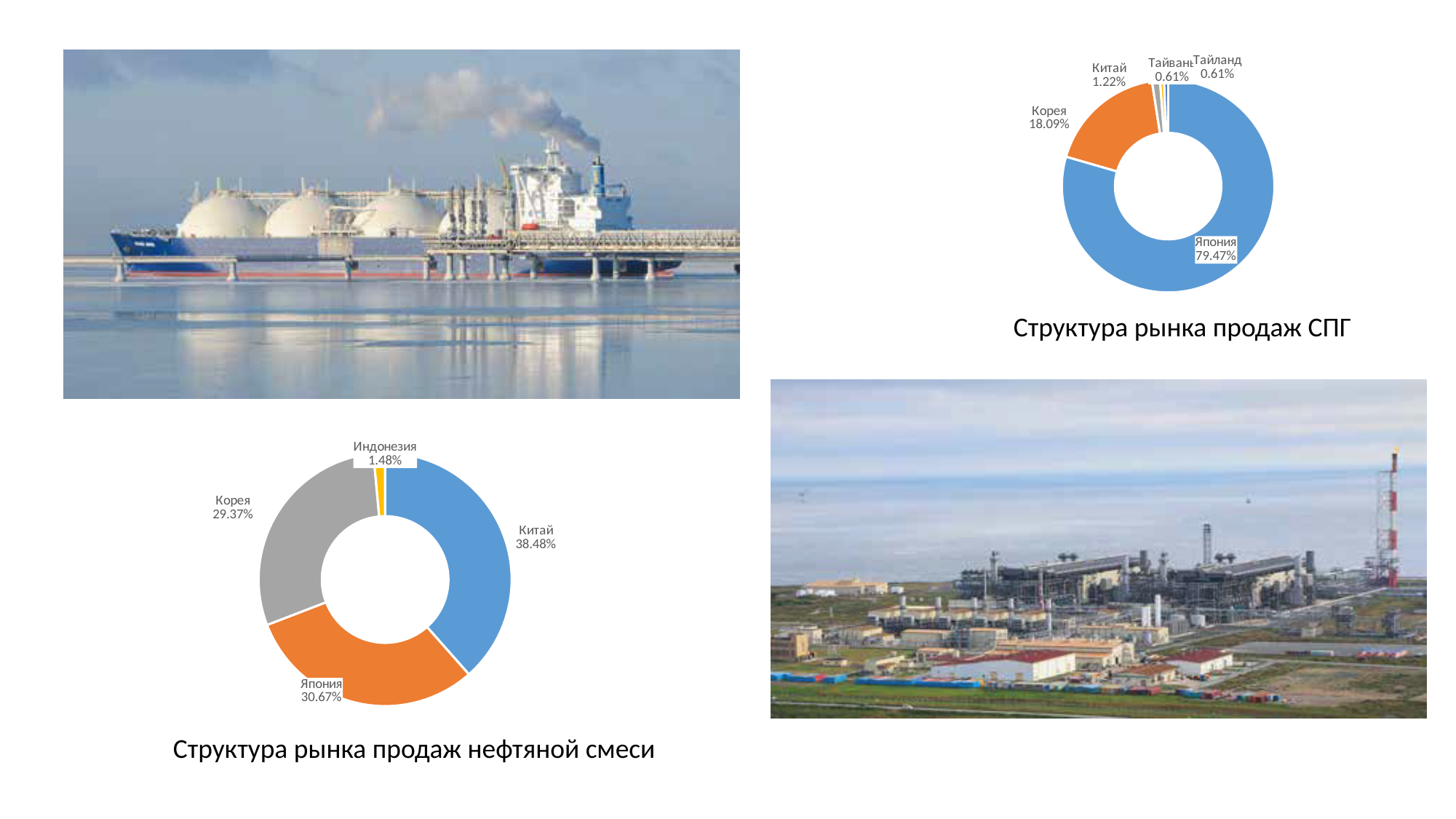
In the chart titled "Структура рынка продаж СПГ", which category has the largest share? Япония In the chart titled "Структура рынка продаж нефтяной смеси", which category has the smallest share? Индонезия In the chart titled "Структура рынка продаж СПГ", what share does Корея have? 18.09% In the chart titled "Структура рынка продаж СПГ", how many categories are shown? 5 In the chart titled "Структура рынка продаж СПГ", what is the difference between the shares of Япония and Корея? 61.38% In the chart titled "Структура рынка продаж нефтяной смеси", how many categories are shown? 4 In the chart titled "Структура рынка продаж нефтяной смеси", what is the difference between the shares of Китай and Япония? 7.81% In the chart titled "Структура рынка продаж нефтяной смеси", what share does Индонезия have? 1.48% In the chart titled "Структура рынка продаж СПГ", what share does Япония have? 79.47% In the chart titled "Структура рынка продаж нефтяной смеси", what share does Китай have? 38.48% What kind of chart is "Структура рынка продаж СПГ"? Doughnut (pie) chart In the chart titled "Структура рынка продаж нефтяной смеси", which is larger, the share of Япония or the share of Корея? Япония